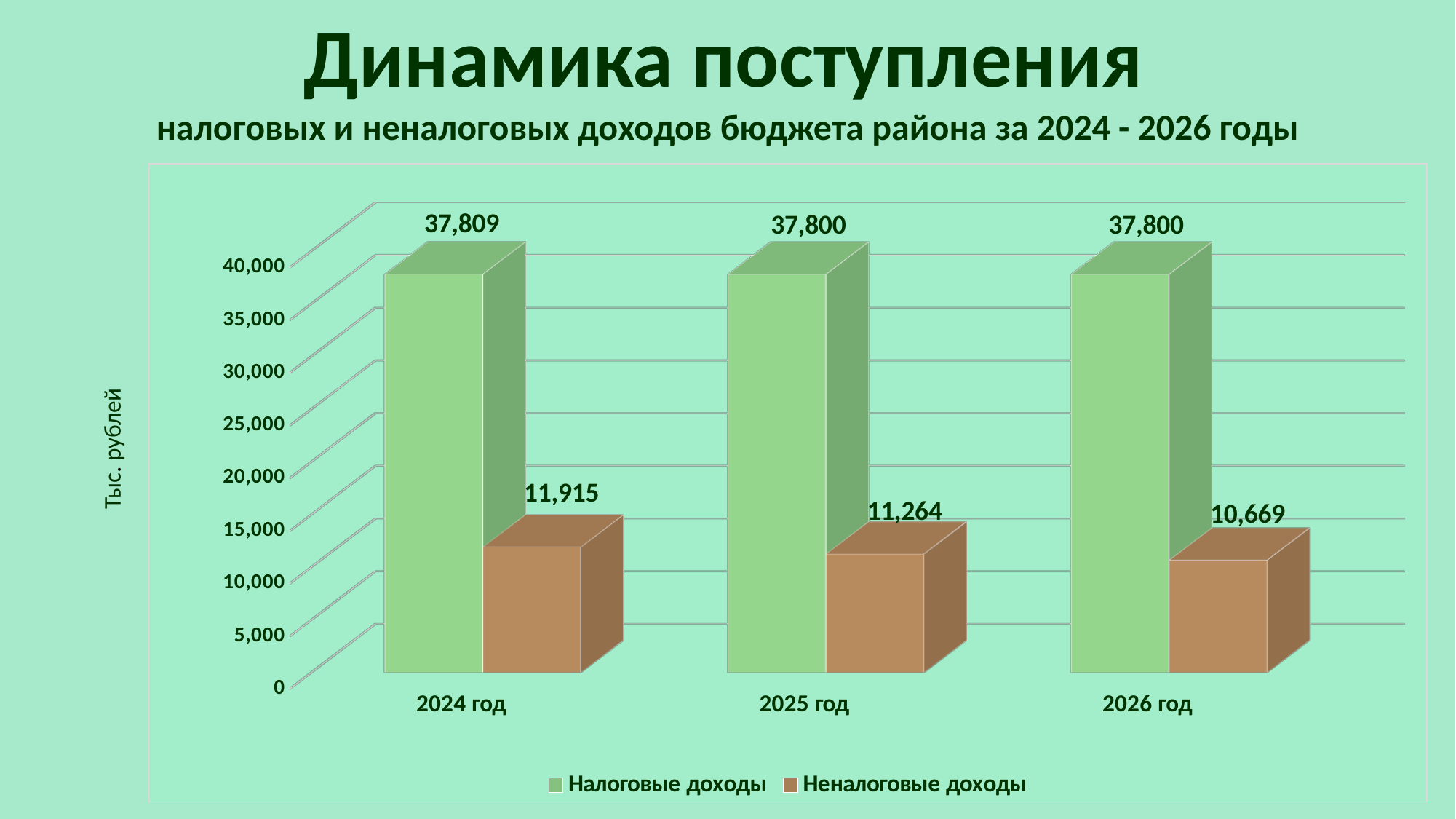
What is the difference between Неналоговые доходы in 2024 год and 2026 год? 1,246 Which year has the highest value for Неналоговые доходы? 2024 год What is the value of Неналоговые доходы for 2026 год? 10,669 What is the value of Налоговые доходы for 2024 год? 37,809 What is the difference between Налоговые доходы and Неналоговые доходы in 2025 год? 26,536 Do the values for Неналоговые доходы rise or fall from 2024 год to 2026 год? fall Which year has the lowest value for Неналоговые доходы? 2026 год What kind of chart is shown on the slide? bar chart How many series does the legend list? 2 How many years are shown on the x axis? 3 What is the value of Неналоговые доходы for 2025 год? 11,264 Which is larger in 2026 год: Налоговые доходы or Неналоговые доходы? Налоговые доходы